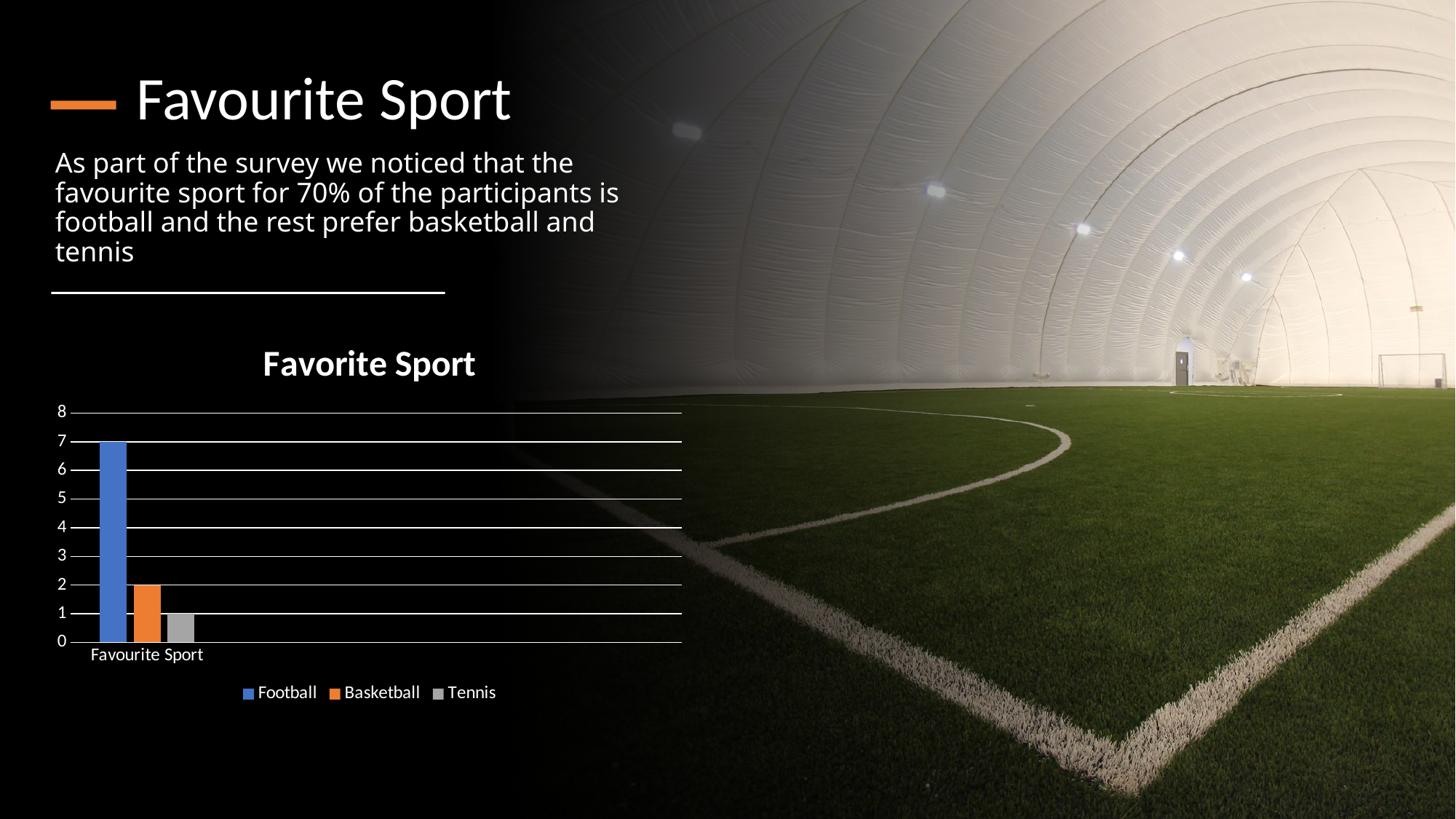
What is the value for Football in the chart? 7 What is the value for Basketball in the chart? 2 Which sport has the lowest value in the chart? Tennis Is the value for Football greater or less than 5? greater Which series are listed in the chart legend? Football, Basketball, Tennis Which is larger, the value for Basketball or the value for Tennis? Basketball What is the value for Tennis in the chart? 1 What kind of chart is shown on the slide? bar chart What is the title of the chart? Favorite Sport How many series does the chart legend list? 3 Which sport has the highest value in the chart? Football What is the difference between the values for Football and Basketball? 5